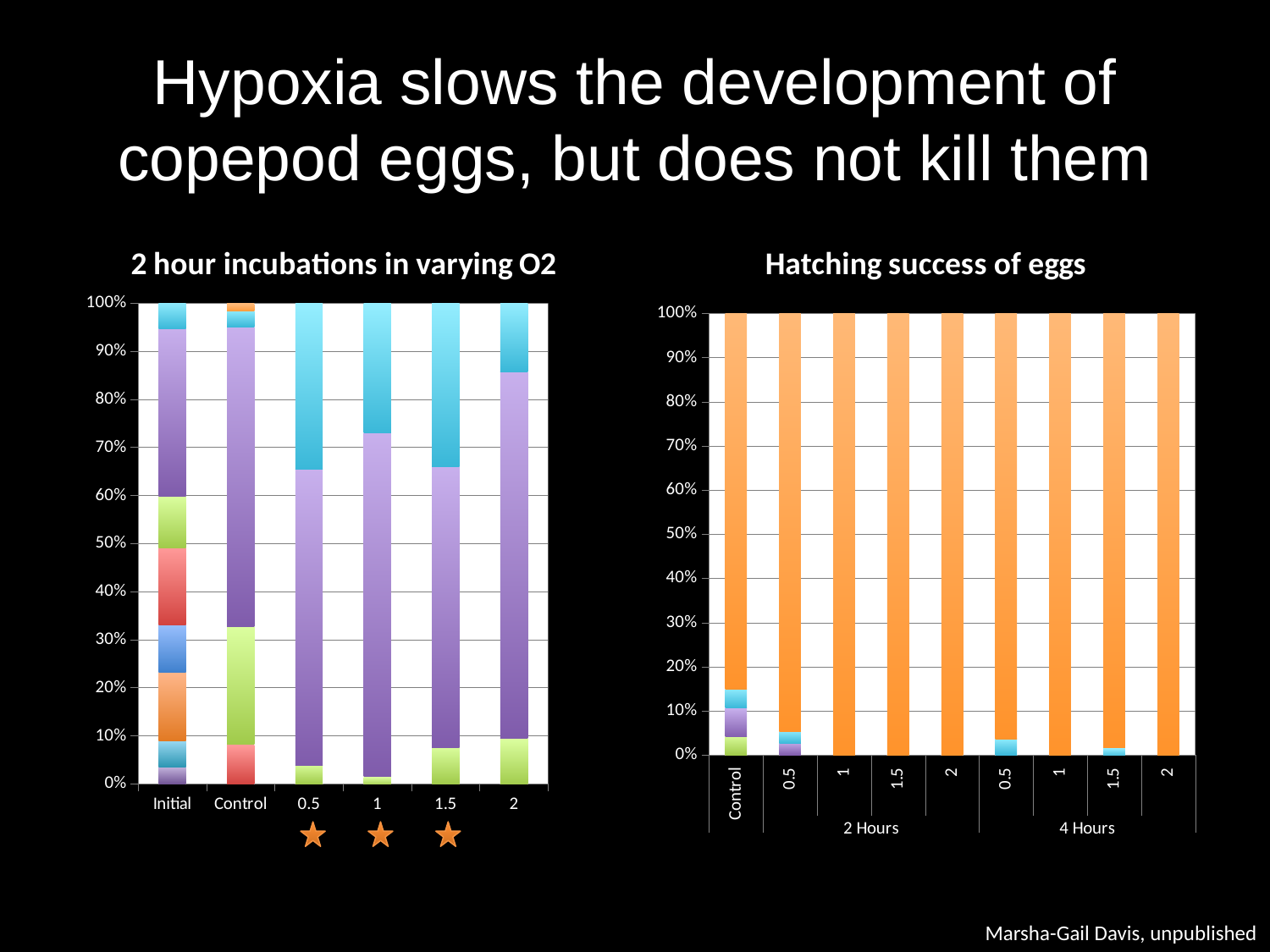
How many bars are plotted in the 'Hatching success of eggs' chart? 9 In the '2 hour incubations in varying O2' chart, is the top of the purple segment for '2' greater or less than 80%? greater What are the two group labels shown beneath the x axis of the 'Hatching success of eggs' chart? 2 Hours and 4 Hours In the '2 hour incubations in varying O2' chart, is the top of the purple segment for '0.5' greater or less than 60%? greater How many categories are shown on the x axis of the '2 hour incubations in varying O2' chart? 6 In the 'Hatching success of eggs' chart, which category has the larger orange segment, 'Control' or '1' under '2 Hours'? 1 In the 'Hatching success of eggs' chart, is the bottom of the orange segment for 'Control' greater or less than 10%? greater In the '2 hour incubations in varying O2' chart, what is the total height of the stacked bar for 'Initial'? 100% In the '2 hour incubations in varying O2' chart, which category has the larger cyan (top) segment, '1' or '2'? 1 What is the title of the chart on the left of the slide? 2 hour incubations in varying O2 What kind of chart is the '2 hour incubations in varying O2' chart? stacked bar chart